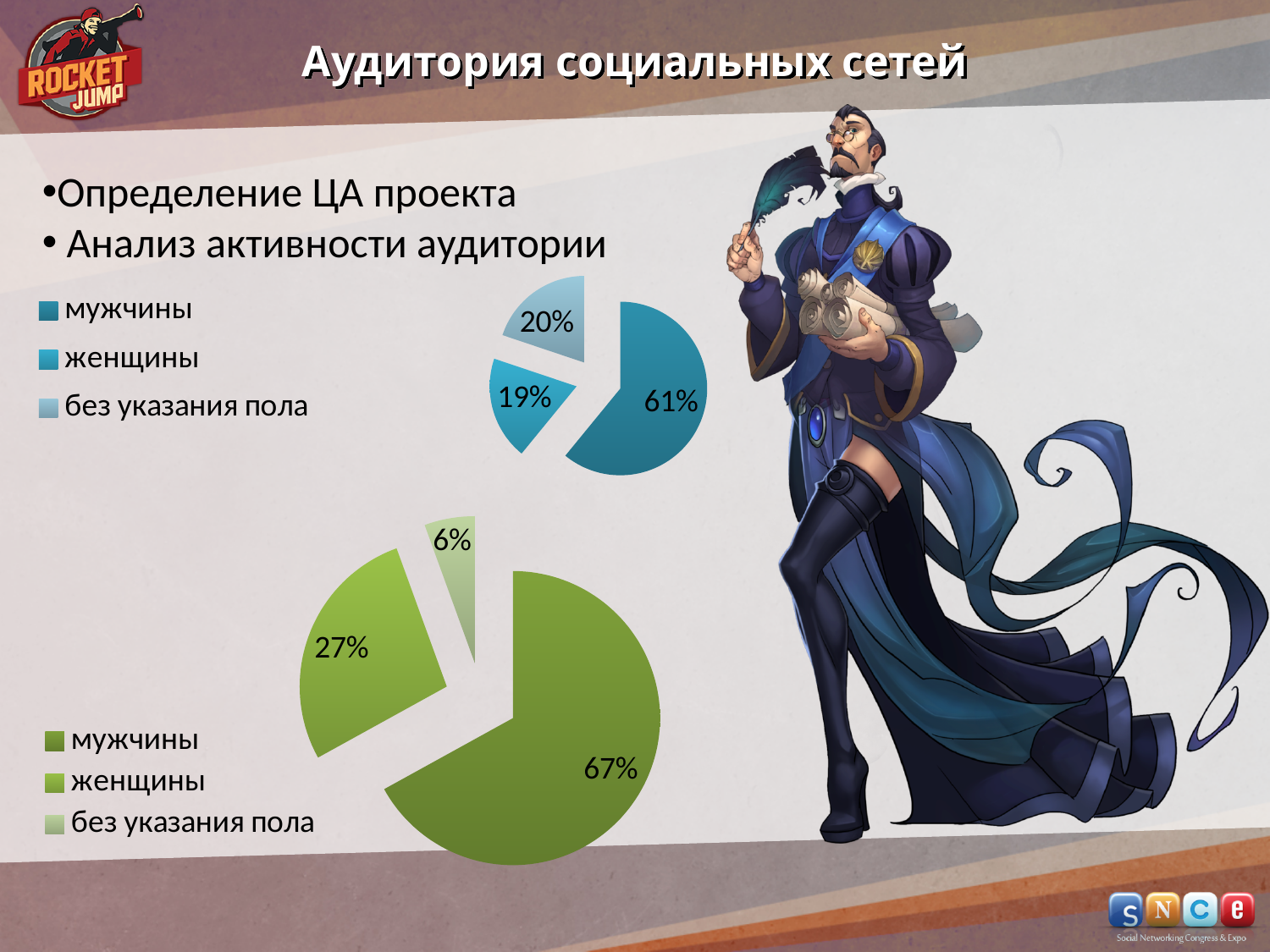
In the lower green pie chart, what share is labelled for без указания пола? 6% How many categories does the legend of the lower green pie chart list? 3 In the lower green pie chart, what is the difference between the shares for мужчины and женщины? 40% In the lower green pie chart, what share is labelled for женщины? 27% In the upper blue pie chart, what share is labelled for женщины? 19% In the upper blue pie chart, which category has the largest slice? мужчины In the lower green pie chart, what share is labelled for мужчины? 67% In the upper blue pie chart, which is larger: the share for женщины or the share for без указания пола? без указания пола In the lower green pie chart, which category has the smallest slice? без указания пола What type of chart is the upper chart on the slide? Pie chart In the upper blue pie chart, what share is labelled for мужчины? 61% In the upper blue pie chart, what share is labelled for без указания пола? 20%